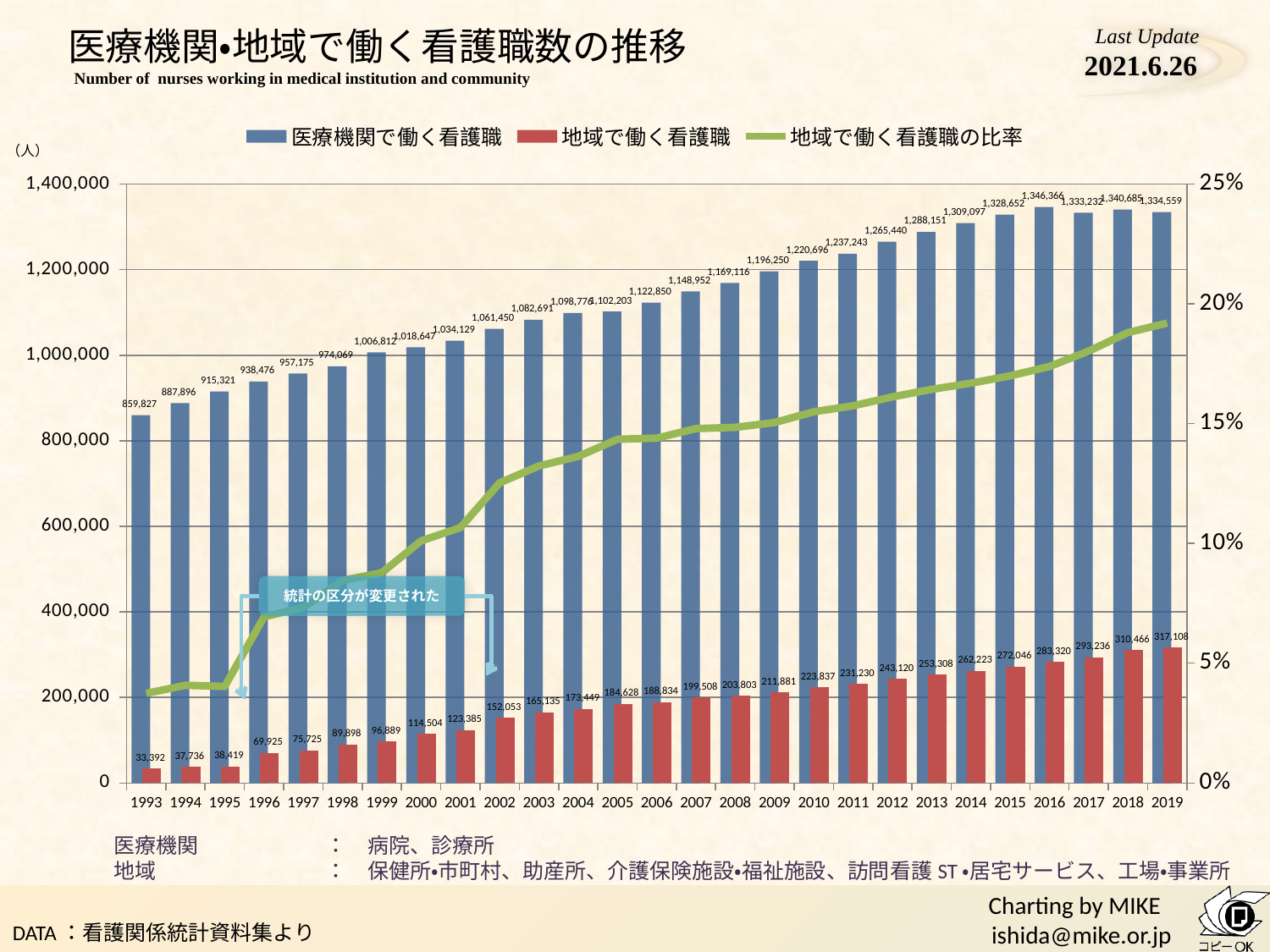
Is the value of 地域で働く看護職の比率 in 2019 greater or less than 20%? less What is the value of 医療機関で働く看護職 in 2019? 1,334,559 What is the difference between 地域で働く看護職 in 2019 and in 2018? 6,642 In which year is 地域で働く看護職 lowest? 1993 Which is larger, 医療機関で働く看護職 in 2016 or in 2017? 2016 In which year is 医療機関で働く看護職 highest? 2016 What is the value of 地域で働く看護職 in 2010? 223,837 How many series does the legend list? 3 Does 地域で働く看護職 rise or fall from 1993 to 2019? rise Is the value of 地域で働く看護職の比率 in 1993 greater or less than 5%? less How many years are shown on the x axis? 27 What is the value of 地域で働く看護職 in 1993? 33,392